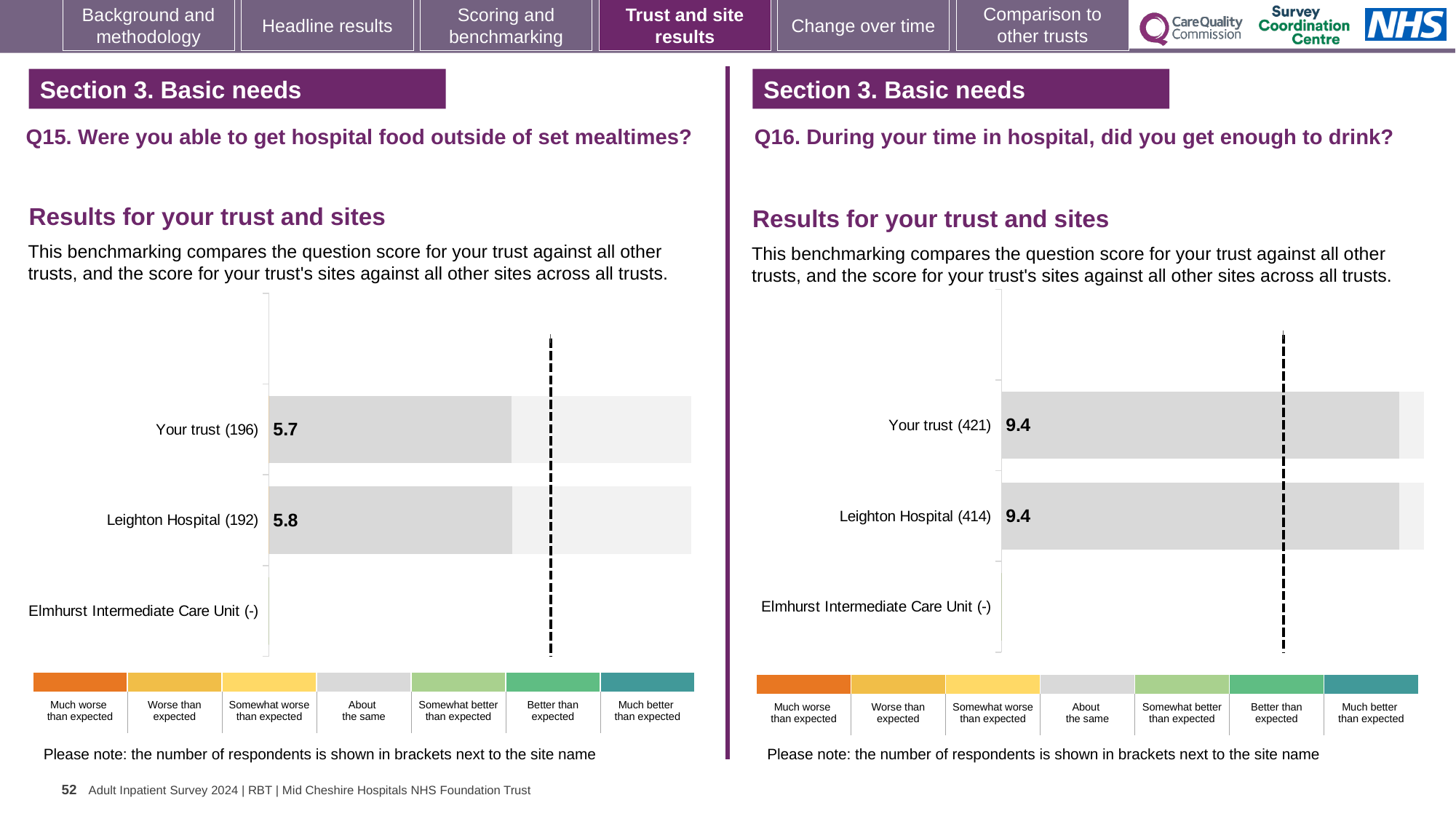
In the Q15 chart (left), what is the score for Your trust? 5.7 In the Q15 chart (left), how many respondents are shown in brackets for Your trust? 196 In the Q15 chart (left), which site or trust has the higher score, Your trust or Leighton Hospital? Leighton Hospital In the Q16 chart (right), how many respondents are shown in brackets for Leighton Hospital? 414 In the Q15 chart (left), what is the difference between the Leighton Hospital score and the Your trust score? 0.1 How many categories are listed on the y axis of the Q16 chart (right)? 3 In the Q16 chart (right), what is the score for Your trust? 9.4 In the Q16 chart (right), which category has no score shown? Elmhurst Intermediate Care Unit In the Q16 chart (right), what is the score for Leighton Hospital? 9.4 In the Q15 chart (left), what is the score for Leighton Hospital? 5.8 How many benchmark categories are shown in the colour key below the Q15 chart (left)? 7 What kind of chart is the Q15 chart (left)? Bar chart